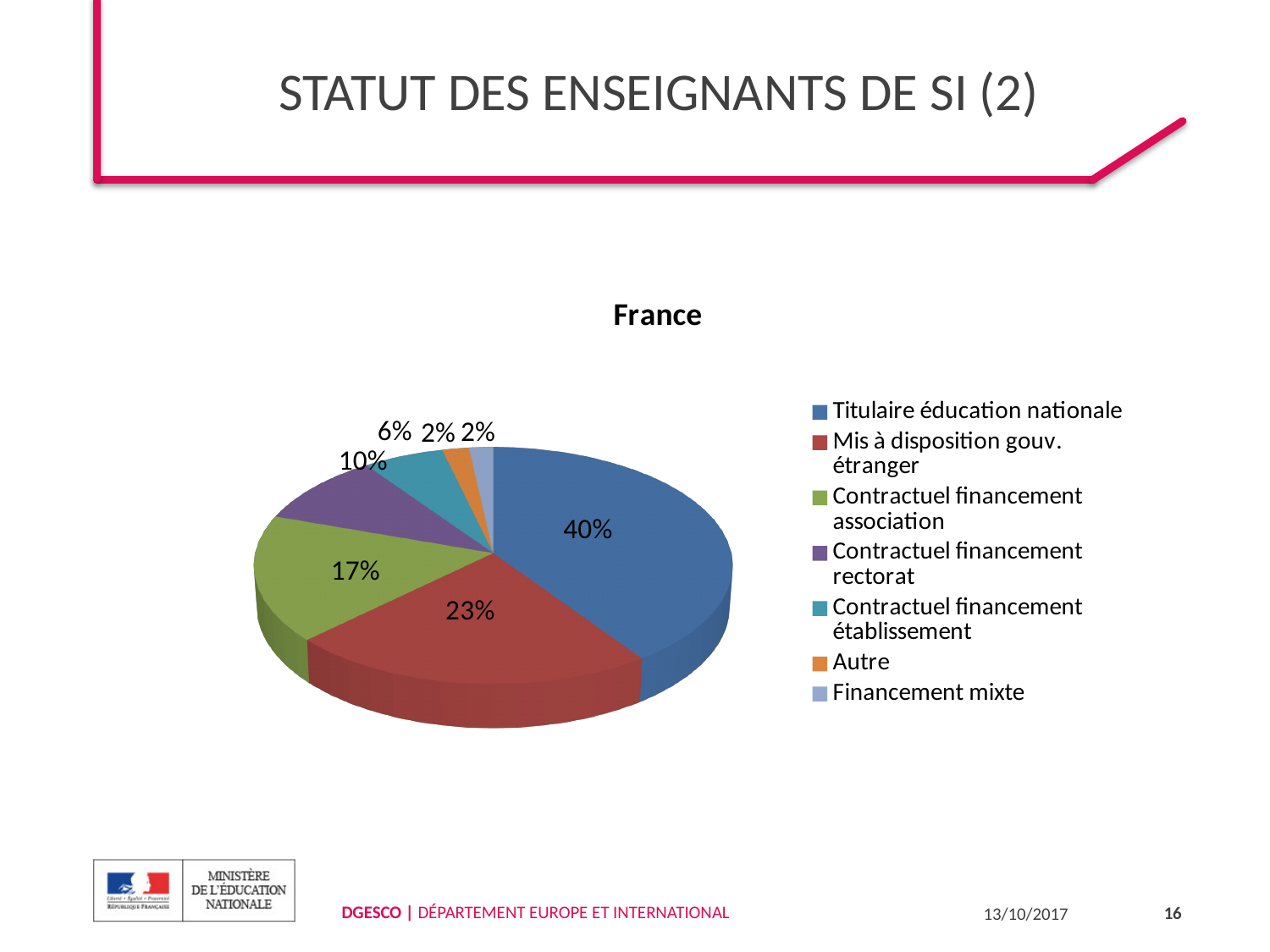
What share of the pie is Mis à disposition gouv. étranger? 23% How many categories does the legend list? 7 Which is larger, Contractuel financement association or Contractuel financement rectorat? Contractuel financement association What share of the pie is Autre? 2% What share of the pie is Contractuel financement association? 17% What is the chart's title? France What is the difference in percentage points between Titulaire éducation nationale and Mis à disposition gouv. étranger? 17 What type of chart is shown on the slide? Pie chart Which category has the largest share of the pie? Titulaire éducation nationale